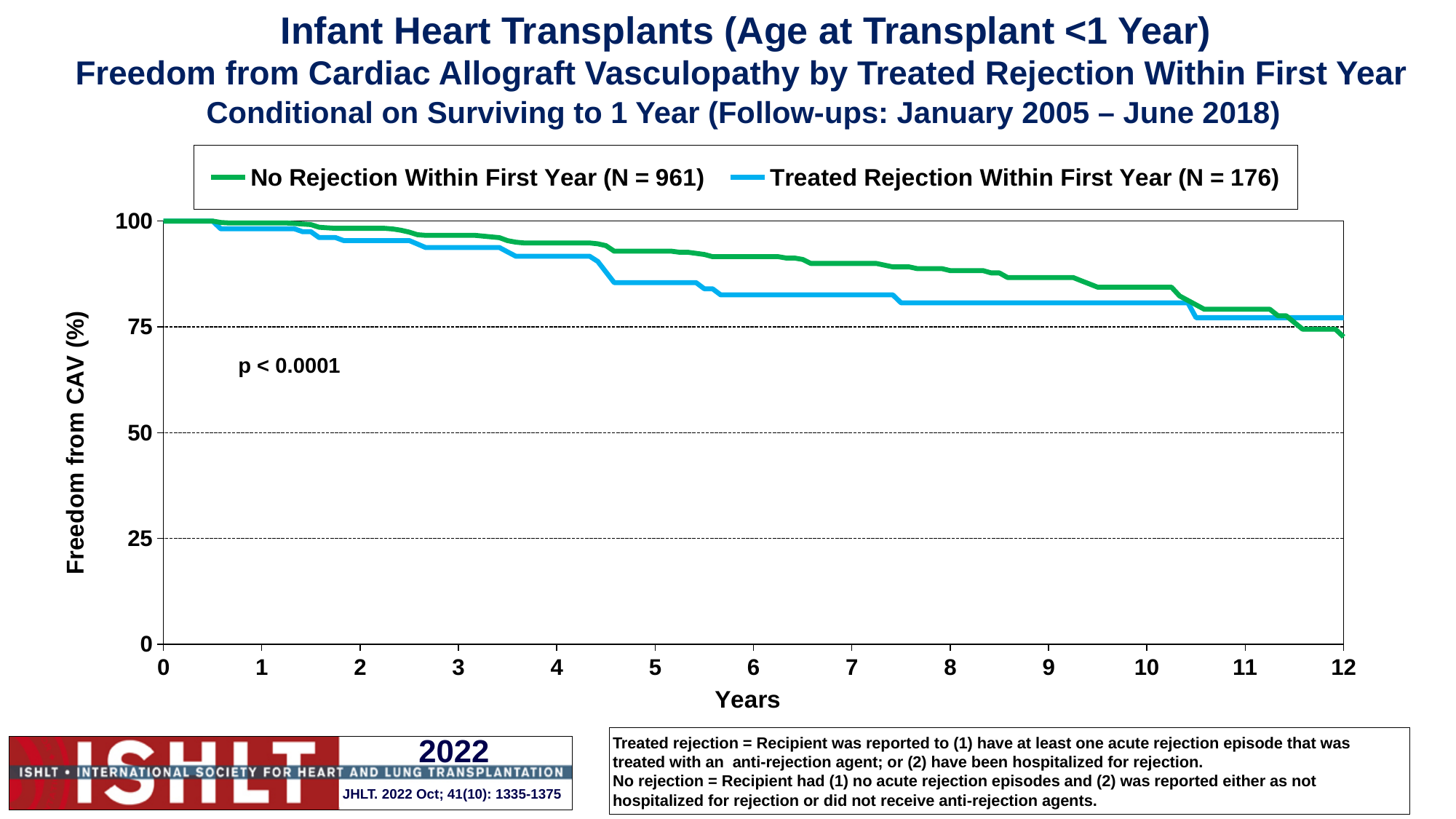
Is the value for the Treated Rejection Within First Year series at 5 years greater or less than 75? greater Is the value for the No Rejection Within First Year series at 8 years greater or less than 75? greater At 8 years, which series has the lower freedom from CAV: No Rejection Within First Year or Treated Rejection Within First Year? Treated Rejection Within First Year How many series does the legend list? 2 Do the values for the Treated Rejection Within First Year series rise or fall as years increase? Fall What kind of chart is shown on the slide? Line chart What is the N for the No Rejection Within First Year group shown in the legend? 961 At 5 years, which series has the higher freedom from CAV: No Rejection Within First Year or Treated Rejection Within First Year? No Rejection Within First Year What p-value is printed on the chart? p < 0.0001 What is the label of the y-axis? Freedom from CAV (%) Do the values for the No Rejection Within First Year series rise or fall as years increase? Fall What is the N for the Treated Rejection Within First Year group shown in the legend? 176